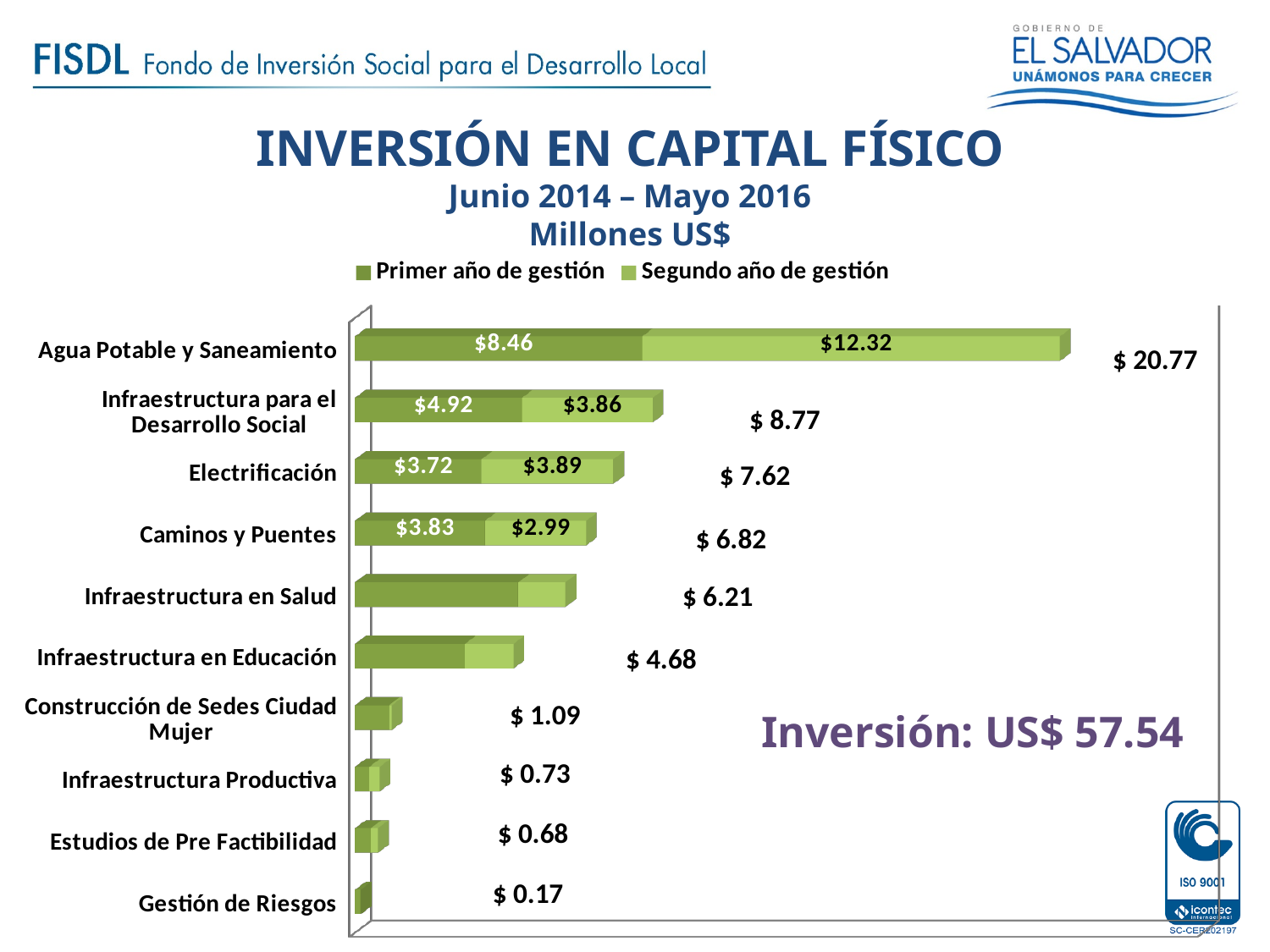
What is the total of the stacked bar for Caminos y Puentes? $ 6.82 What are the two series named in the legend? Primer año de gestión and Segundo año de gestión How many categories are shown in the chart? 10 What is the value of Primer año de gestión for Agua Potable y Saneamiento? $8.46 Which category has the highest total investment? Agua Potable y Saneamiento How many series does the legend list? 2 What is the value of Segundo año de gestión for Electrificación? $3.89 Which category has the lowest total investment? Gestión de Riesgos Which has a larger total investment, Electrificación or Caminos y Puentes? Electrificación What is the difference between the total for Agua Potable y Saneamiento and the total for Infraestructura para el Desarrollo Social? $ 12.00 What kind of chart is shown on the slide? Stacked bar chart What is the total investment shown for Infraestructura en Salud? $ 6.21